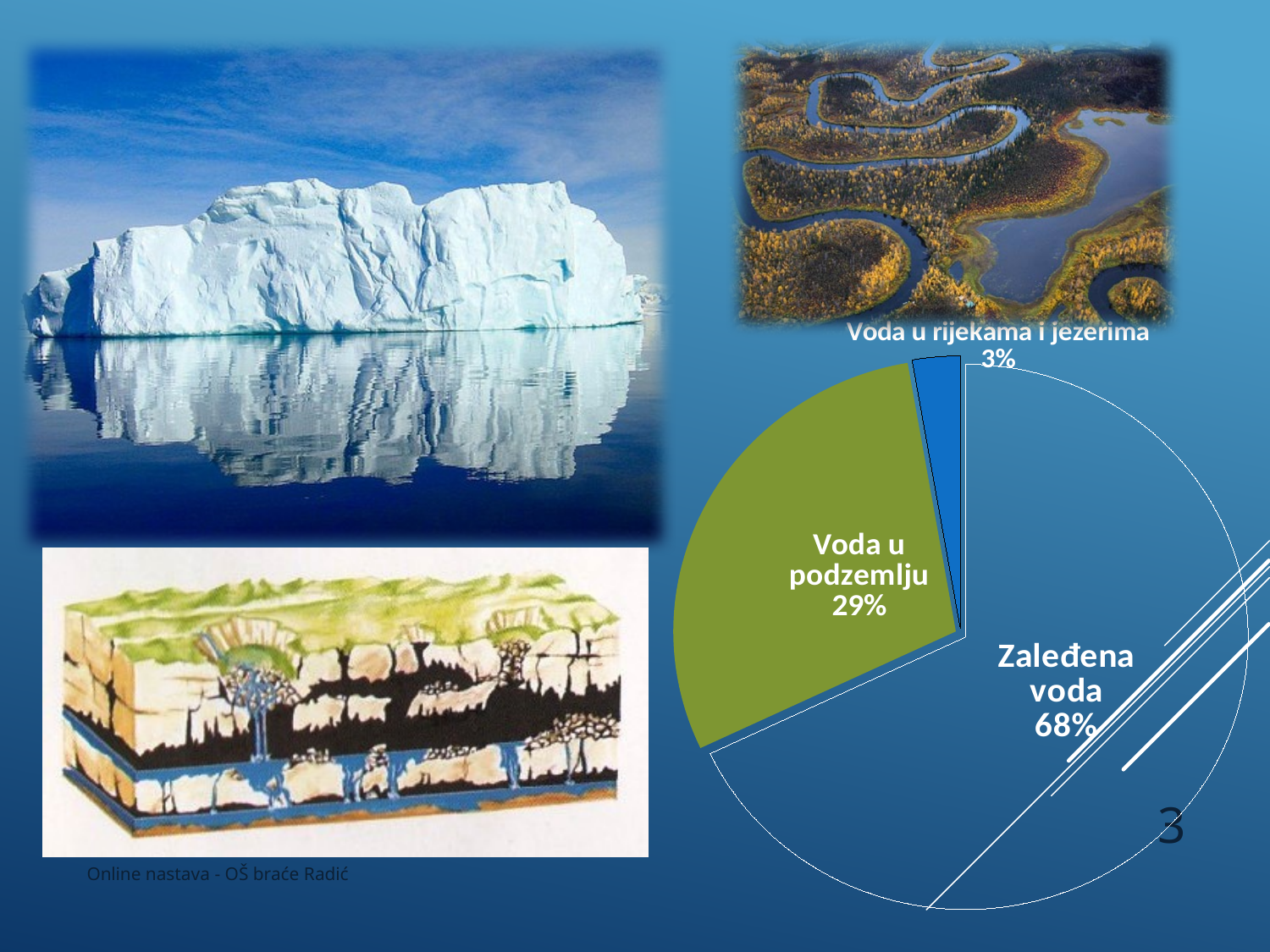
What is the difference in percentage points between "Zaleđena voda" and "Voda u podzemlju"? 39 What colour is the "Voda u podzemlju" slice in the pie chart? green Is the share for "Zaleđena voda" greater or less than 50%? greater What share of the pie does "Zaleđena voda" take? 68% Which is larger, the share for "Voda u podzemlju" or the share for "Voda u rijekama i jezerima"? Voda u podzemlju What kind of chart is shown on the slide? pie chart What share of the pie does "Voda u podzemlju" take? 29% Which slice of the pie chart is the smallest? Voda u rijekama i jezerima What share of the pie does "Voda u rijekama i jezerima" take? 3% Which slice of the pie chart is the largest? Zaleđena voda How many slices does the pie chart have? 3 What is the difference in percentage points between "Voda u podzemlju" and "Voda u rijekama i jezerima"? 26